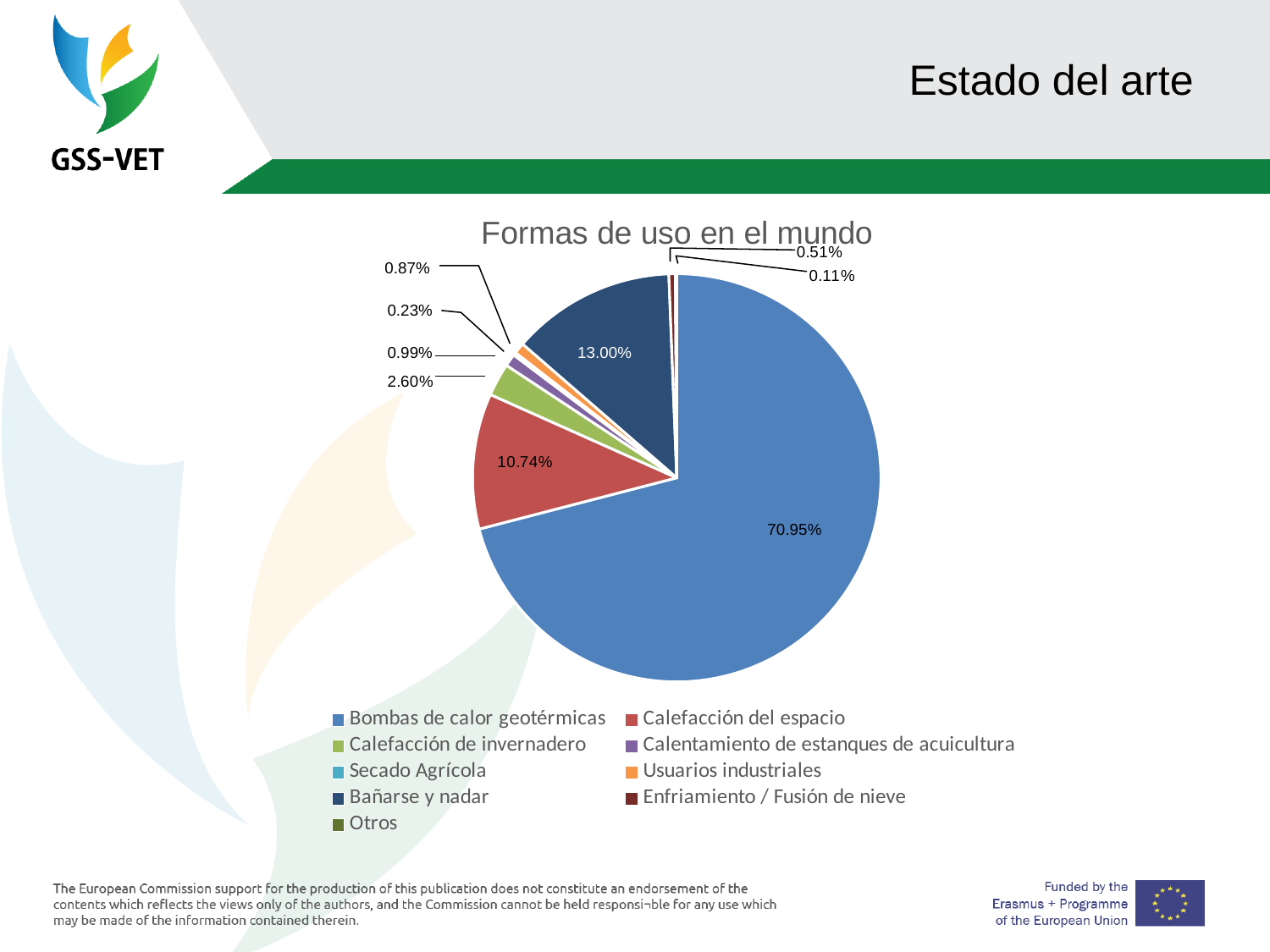
Which category has the largest slice of the pie? Bombas de calor geotérmicas What is the title of the chart? Formas de uso en el mundo What is the combined share of Bombas de calor geotérmicas and Calefacción del espacio? 81.69% Which is larger, Bañarse y nadar or Calefacción del espacio? Bañarse y nadar What is the difference between the shares of Bombas de calor geotérmicas and Bañarse y nadar? 57.95% What share of the pie does Bombas de calor geotérmicas represent? 70.95% What is the value shown for Calefacción de invernadero? 2.60% How many categories does the legend of the pie chart list? 9 What is the value shown for Calefacción del espacio? 10.74% Which category has the smallest slice of the pie? Otros What is the value shown for Bañarse y nadar? 13.00% What type of chart is shown on the slide? pie chart